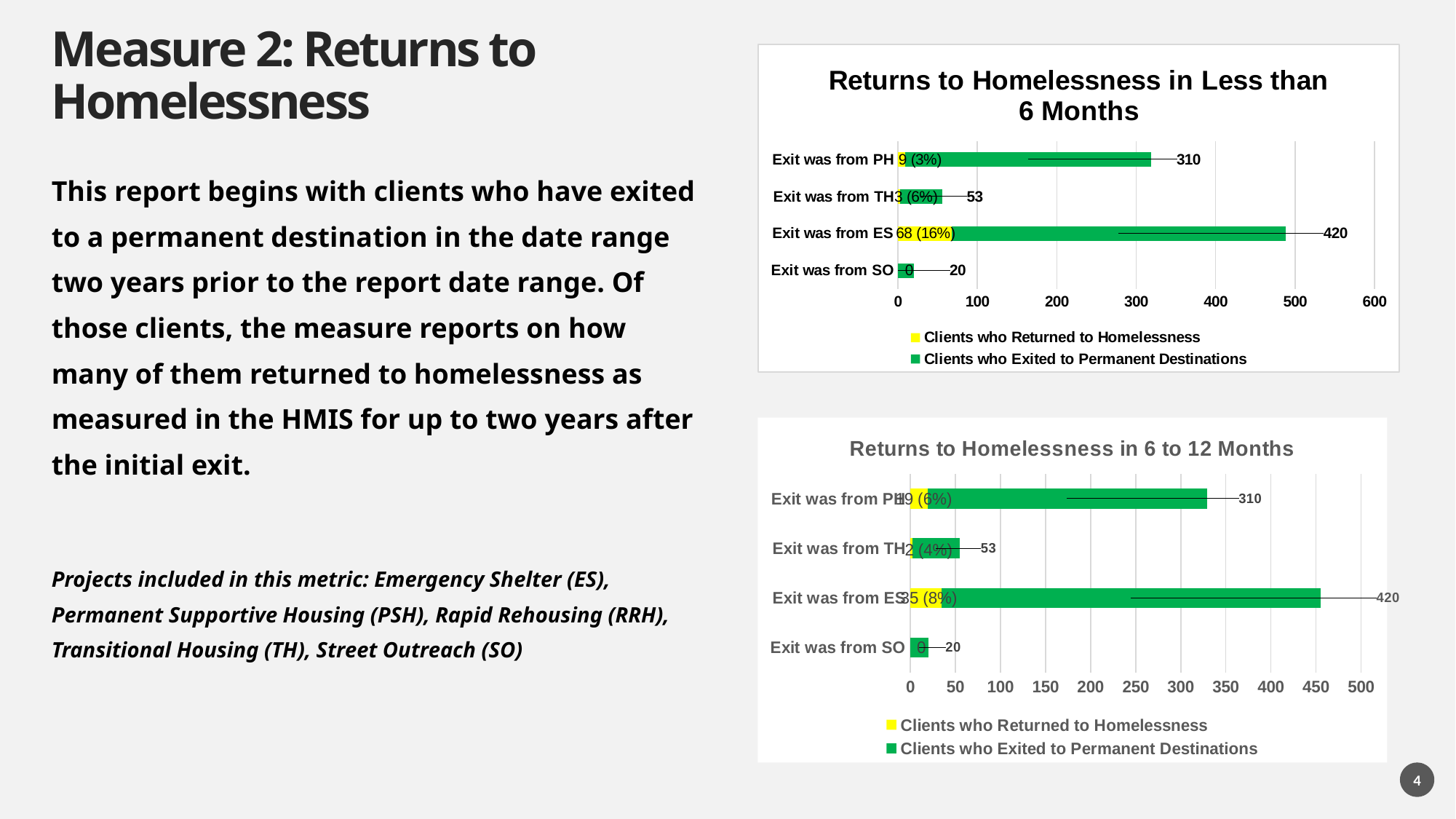
In the 'Returns to Homelessness in 6 to 12 Months' chart, what is the data label for clients who returned to homelessness after exiting from ES? 35 (8%) In the 'Returns to Homelessness in Less than 6 Months' chart, what colour represents 'Clients who Returned to Homelessness'? yellow In the 'Returns to Homelessness in Less than 6 Months' chart, what is the difference between clients who exited to permanent destinations from ES and from PH? 110 In the 'Returns to Homelessness in Less than 6 Months' chart, which exit category has the highest number of clients who exited to permanent destinations? Exit was from ES How many series does the legend of the 'Returns to Homelessness in 6 to 12 Months' chart list? 2 In the 'Returns to Homelessness in Less than 6 Months' chart, what is the data label for clients who returned to homelessness after exiting from ES? 68 (16%) What kind of chart is 'Returns to Homelessness in Less than 6 Months'? bar chart In the 'Returns to Homelessness in Less than 6 Months' chart, which exit category has the lowest number of clients who exited to permanent destinations? Exit was from SO In the 'Returns to Homelessness in Less than 6 Months' chart, how many clients who exited from ES exited to permanent destinations? 420 In the 'Returns to Homelessness in 6 to 12 Months' chart, what is the data label for clients who returned to homelessness after exiting from PH? 19 (6%) How many exit categories are shown in the 'Returns to Homelessness in Less than 6 Months' chart? 4 In the 'Returns to Homelessness in 6 to 12 Months' chart, which has more clients who returned to homelessness: exits from PH or exits from ES? Exit was from ES